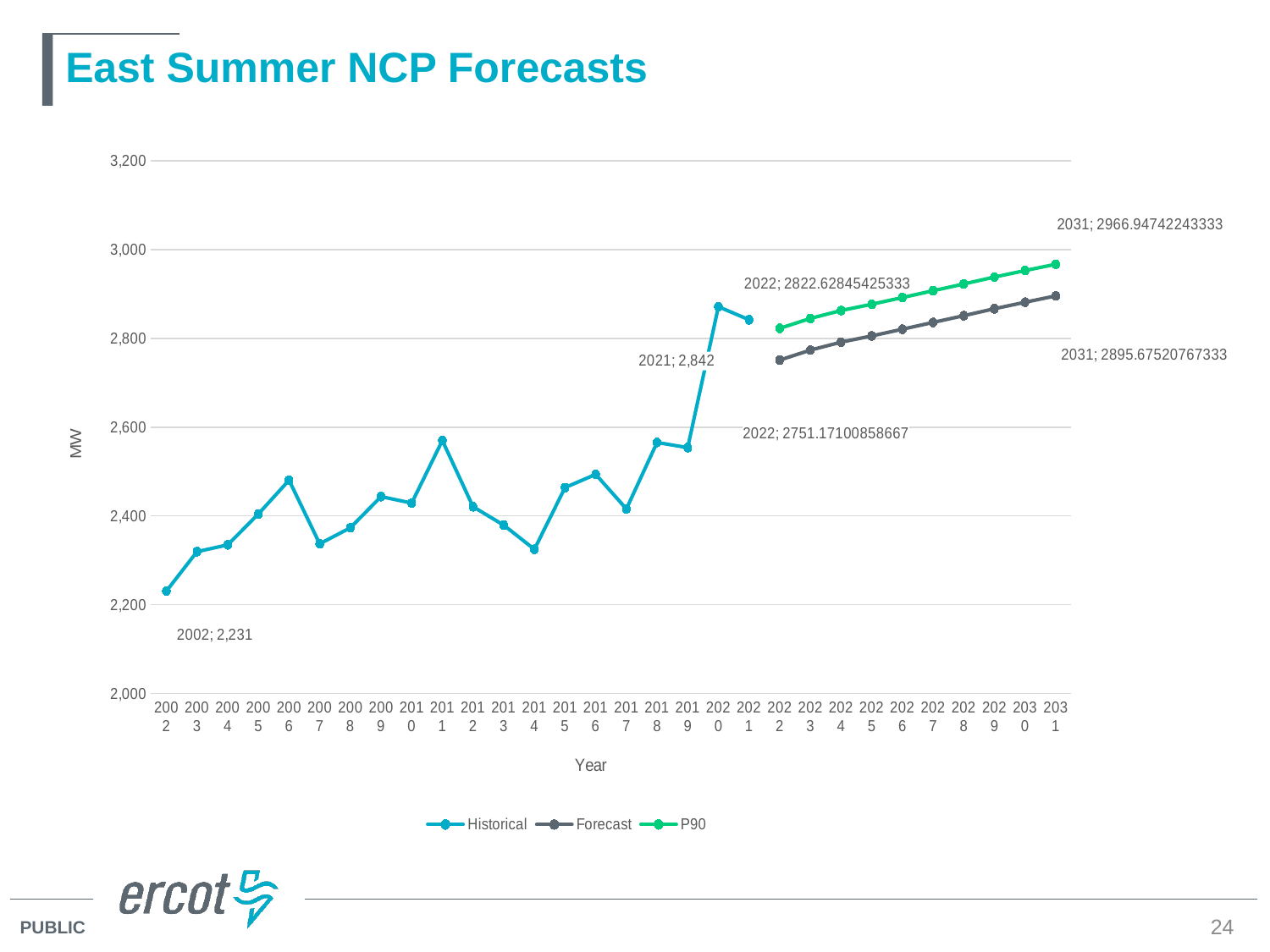
What is the Historical value for 2002? 2,231 What type of chart is shown on the slide? line chart What is the Forecast value for 2031? 2895.67520767333 How many series does the legend list? 3 Is the Historical value for 2014 greater or less than 2,400? less By how much did the Historical value in 2021 exceed the Historical value in 2002? 611 What is the P90 value for 2031? 2966.94742243333 What is the Historical value for 2021? 2,842 What is the Forecast value for 2022? 2751.17100858667 Which series has the larger value in 2031, P90 or Forecast? P90 Is the Historical value for 2011 greater or less than 2,400? greater Does the Forecast series rise or fall from 2022 to 2031? rises